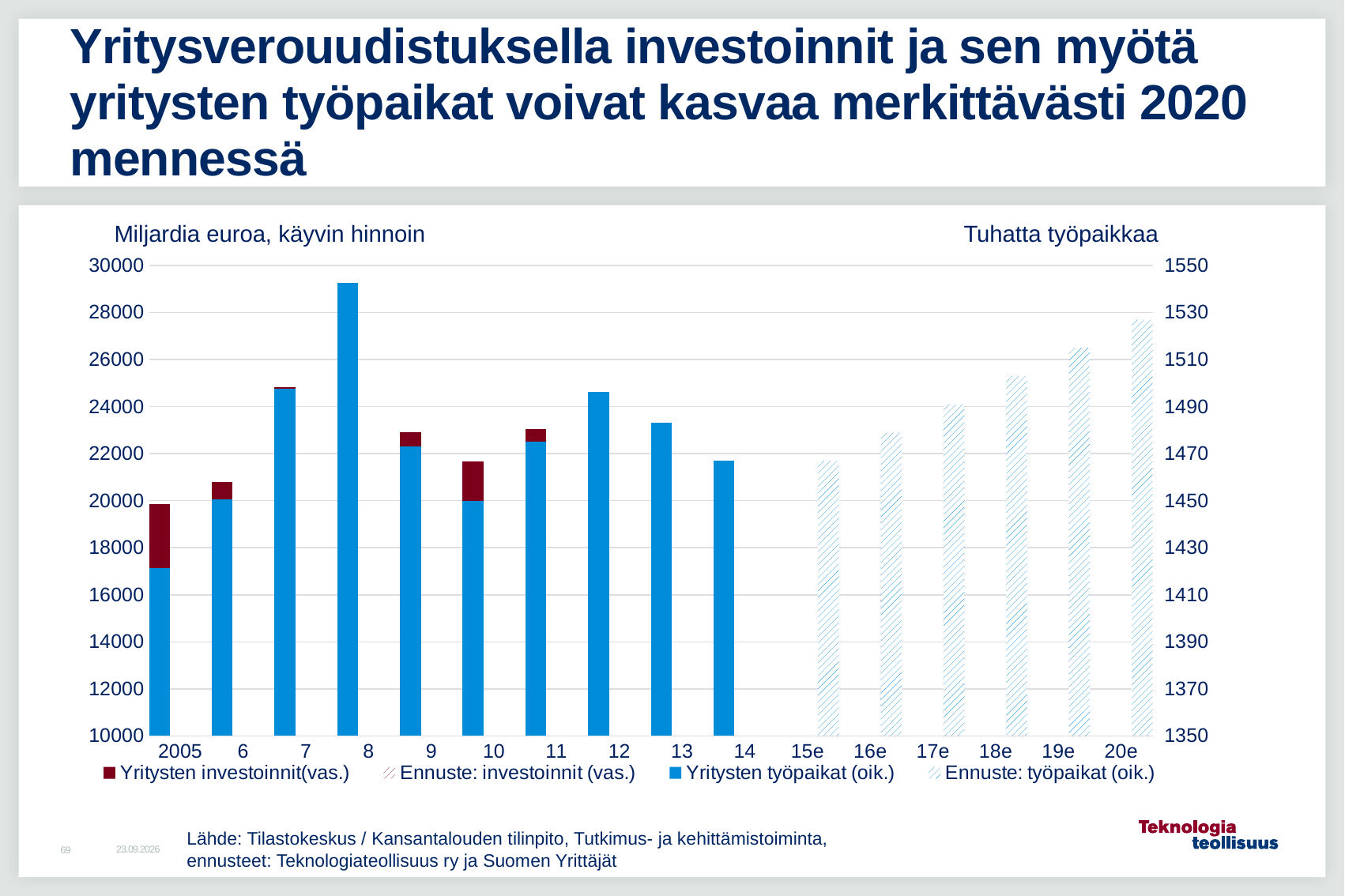
What kind of chart is shown on the slide? bar chart What unit label is shown above the right axis? Tuhatta työpaikkaa Is the Yritysten työpaikat value for 2008 greater or less than 1530 on the right axis? greater Which is larger, the Yritysten työpaikat bar for 2012 or for 2013? 2012 Is the Ennuste: työpaikat value for 20e greater or less than 1510 on the right axis? greater Do the Ennuste: työpaikat forecast bars rise or fall from 15e to 20e? rise How many series does the legend list? 4 Which is larger, the Ennuste: työpaikat bar for 18e or for 19e? 19e Which year has the lowest bar for Yritysten työpaikat (oik.)? 2005 Which year has the highest bar for Yritysten työpaikat (oik.)? 2008 Is the Ennuste: työpaikat value for 15e greater or less than 1450 on the right axis? greater How many year categories are shown on the x axis? 16